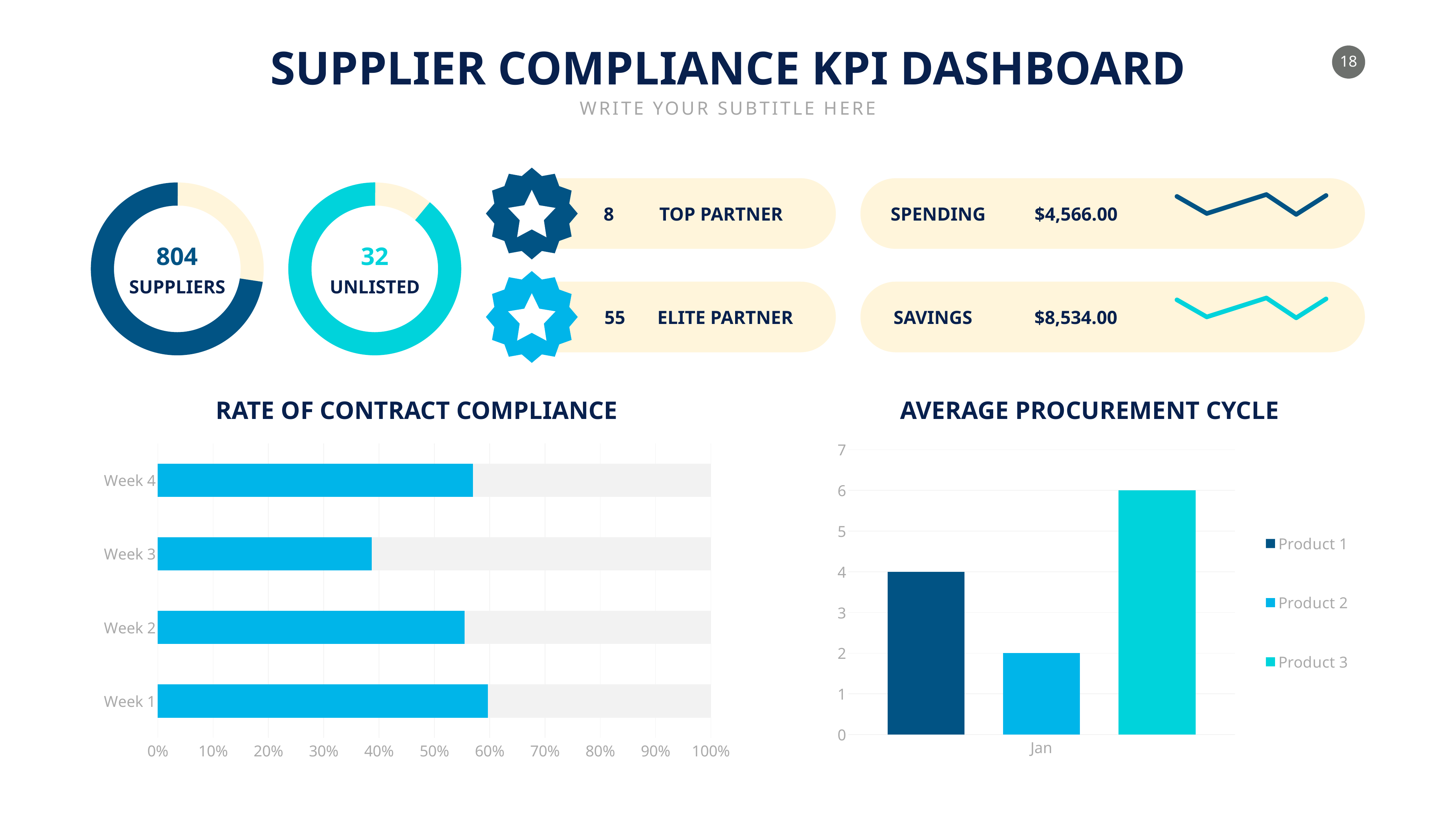
What kind of chart is the Rate of Contract Compliance chart? Bar chart In the Average Procurement Cycle chart, what is the difference between the values for Product 3 and Product 2? 4 In the Average Procurement Cycle chart, what is the value for Product 1? 4 In the Average Procurement Cycle chart, what is the value for Product 3? 6 In the Rate of Contract Compliance chart, which week has the lowest value? Week 3 In the Rate of Contract Compliance chart, which is larger, the value for Week 1 or the value for Week 3? Week 1 In the Average Procurement Cycle chart, which product has the highest value? Product 3 How many series does the legend of the Average Procurement Cycle chart list? 3 In the Average Procurement Cycle chart, which product has the lowest value? Product 2 In the Rate of Contract Compliance chart, is the value for Week 4 greater or less than 50%? greater How many weeks are shown in the Rate of Contract Compliance chart? 4 In the Rate of Contract Compliance chart, is the value for Week 3 greater or less than 40%? less